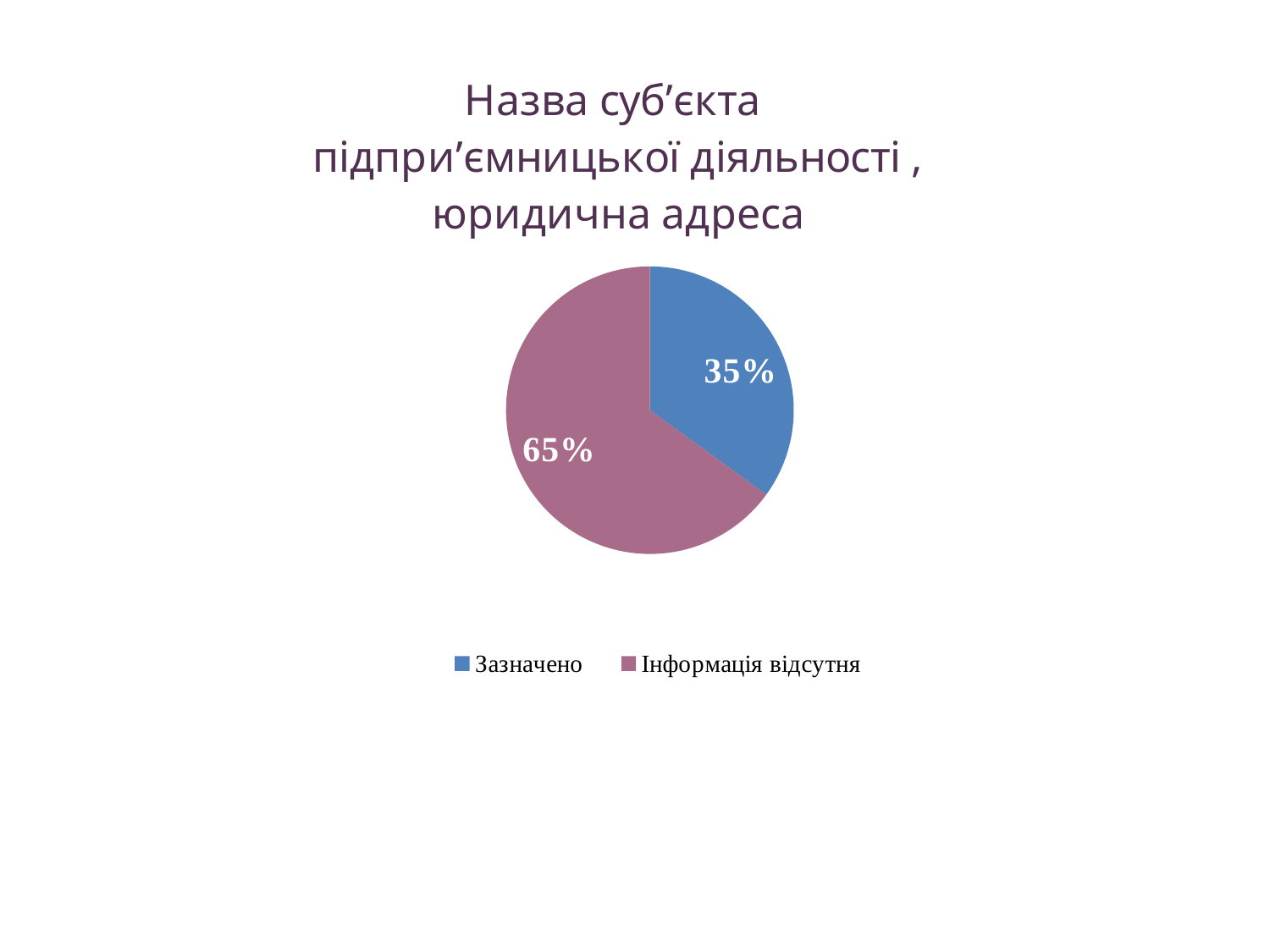
What is the title of the chart? Назва суб’єкта підпри’ємницької діяльності , юридична адреса Which slice is the smallest? Зазначено How many entries does the legend list? 2 What colour is the "Зазначено" slice? blue Which slice is the largest? Інформація відсутня Which is larger, "Зазначено" or "Інформація відсутня"? Інформація відсутня What is the difference in percentage points between "Інформація відсутня" and "Зазначено"? 30% What kind of chart is shown on the slide? pie chart What share of the pie does "Інформація відсутня" represent? 65% How many slices does the pie chart have? 2 What share of the pie does "Зазначено" represent? 35%